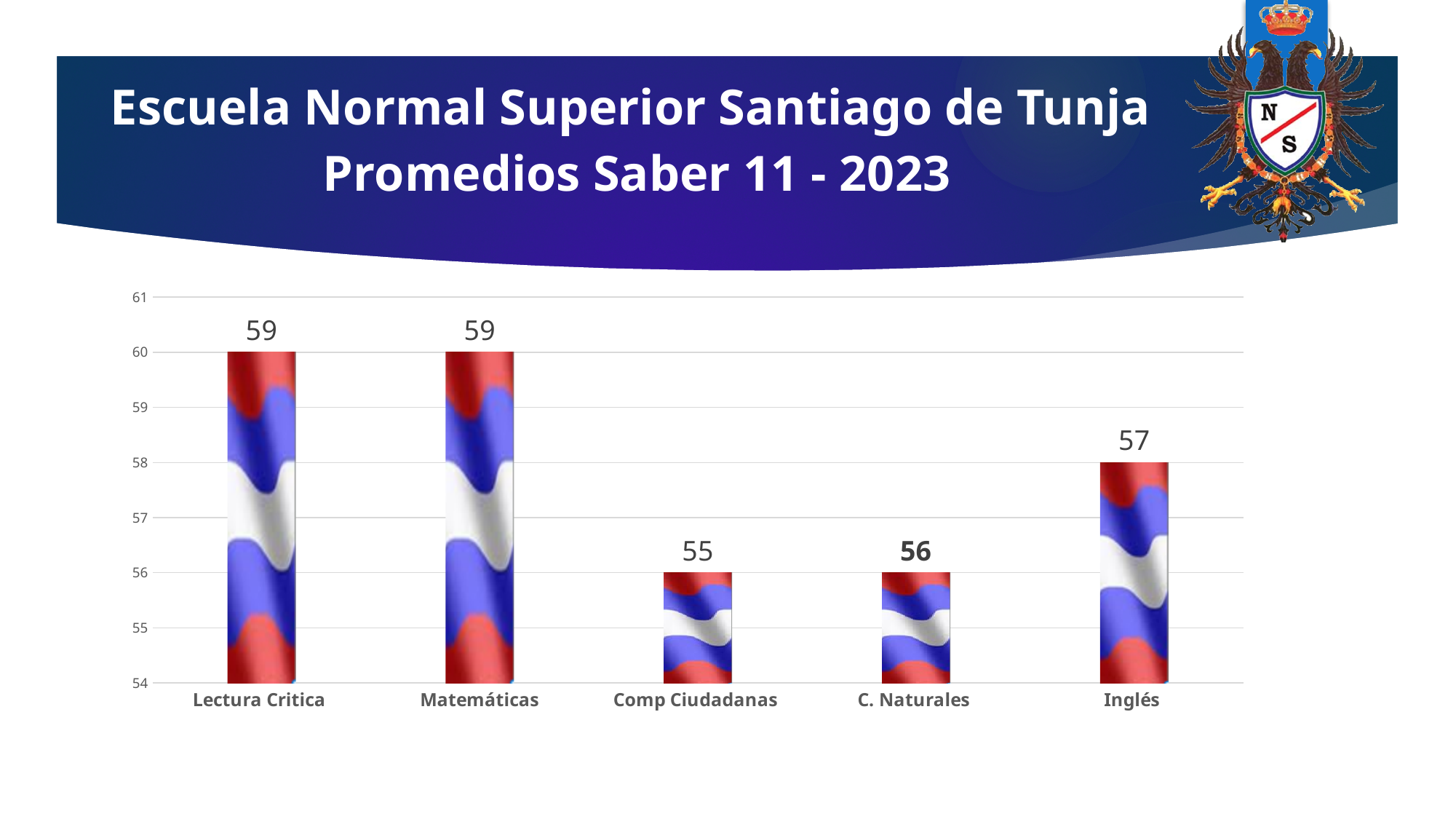
Is the value for Inglés greater or less than 56? greater What is the value for Inglés? 57 What kind of chart is shown on the slide? bar chart What is the value for C. Naturales? 56 Which is larger, the value for Inglés or the value for C. Naturales? Inglés What is the difference between the values for Inglés and Comp Ciudadanas? 2 What is the value for Lectura Critica? 59 How many categories are shown on the x axis? 5 What is the value for Comp Ciudadanas? 55 What is the value for Matemáticas? 59